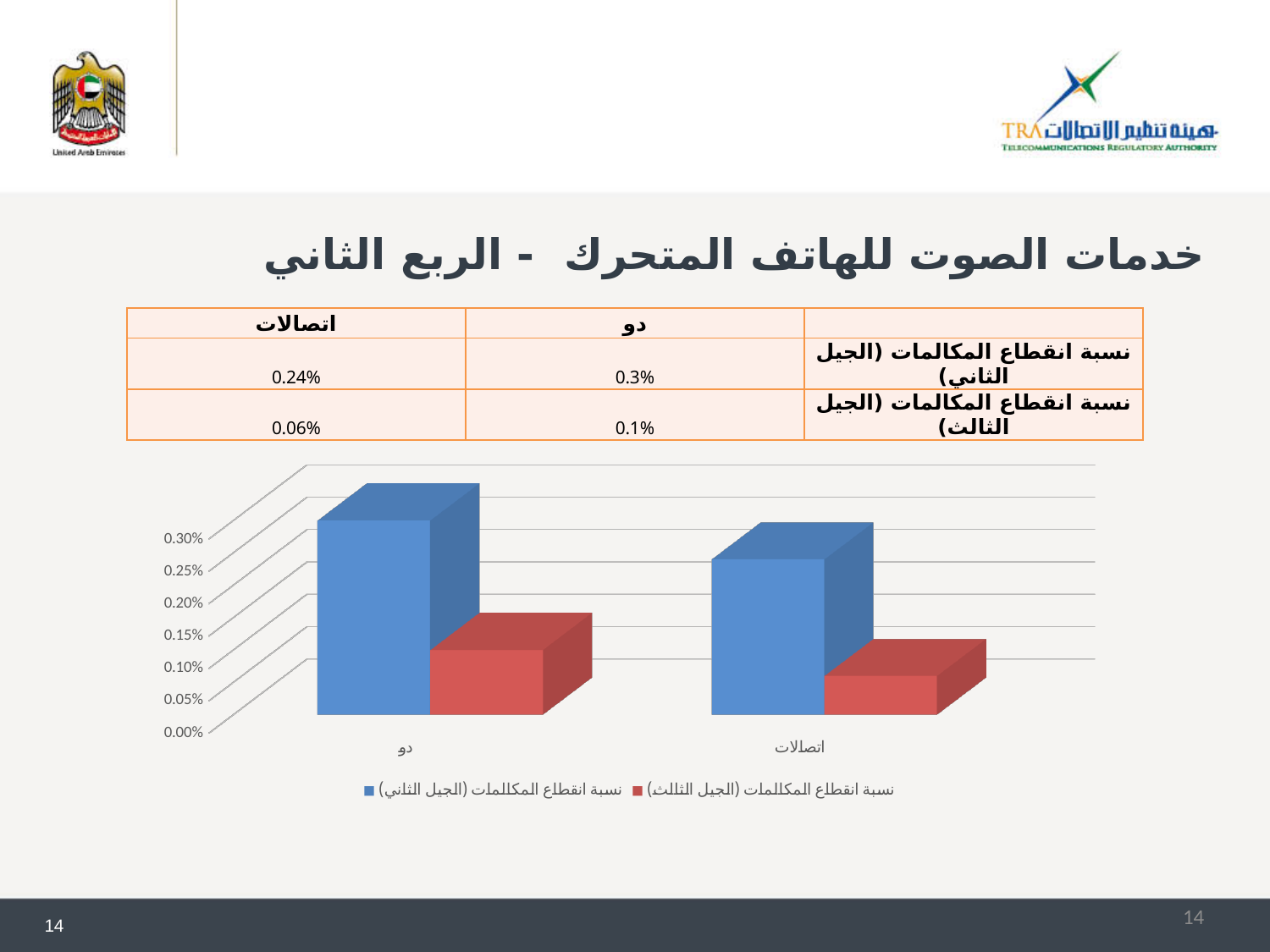
Which operator has the higher 2G call drop rate (الجيل الثاني), دو or اتصالات? دو How many operator categories are shown on the x axis of the chart? 2 Which operator has the lowest 3G call drop rate (الجيل الثالث)? اتصالات What is the difference between the 2G call drop rates of دو and اتصالات shown in the table? 0.06% According to the table, what is the call drop rate (3G, الجيل الثالث) for اتصالات? 0.06% In the chart, is the 2G call drop rate bar for دو greater or less than 0.25%? greater In the chart, is the 3G call drop rate bar for اتصالات greater or less than 0.10%? less What kind of chart is shown on the slide? bar chart What is the title of the slide containing the chart? خدمات الصوت للهاتف المتحرك - الربع الثاني According to the table, what is the call drop rate (2G, الجيل الثاني) for دو? 0.3% How many series does the chart legend list? 2 According to the table, what is the call drop rate (3G, الجيل الثالث) for دو? 0.1%